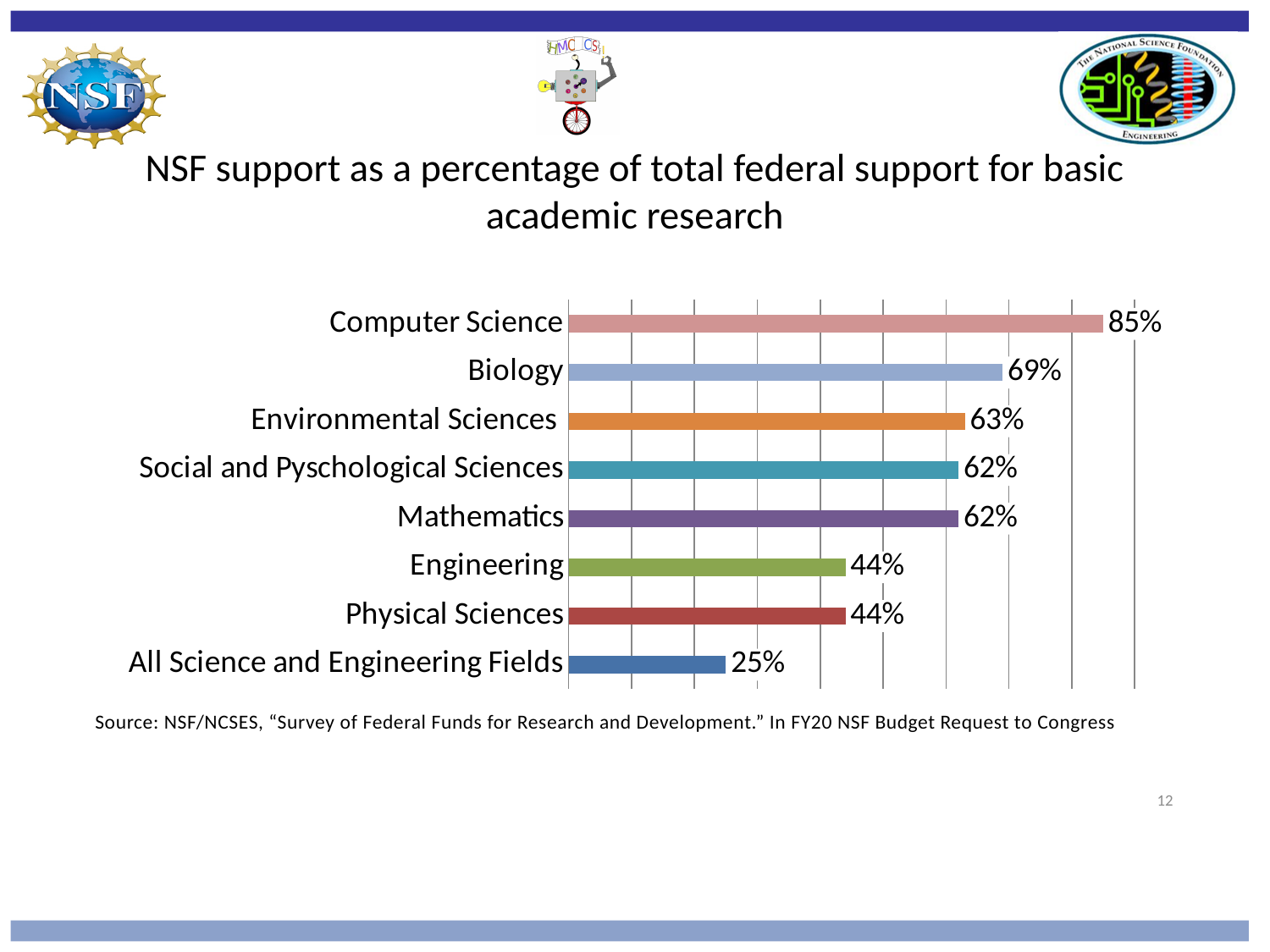
What is the difference between the values for Computer Science and Biology? 16% Which category has the lowest value? All Science and Engineering Fields Which is larger, the value for Biology or the value for Physical Sciences? Biology What is the value for All Science and Engineering Fields? 25% What is the value for Biology? 69% What is the value for Computer Science? 85% How many categories are shown in the chart? 8 Which category has the highest value? Computer Science What kind of chart is shown on the slide? Bar chart What is the difference between the values for Environmental Sciences and Engineering? 19% What is the title of the chart? NSF support as a percentage of total federal support for basic academic research What is the value for Environmental Sciences? 63%